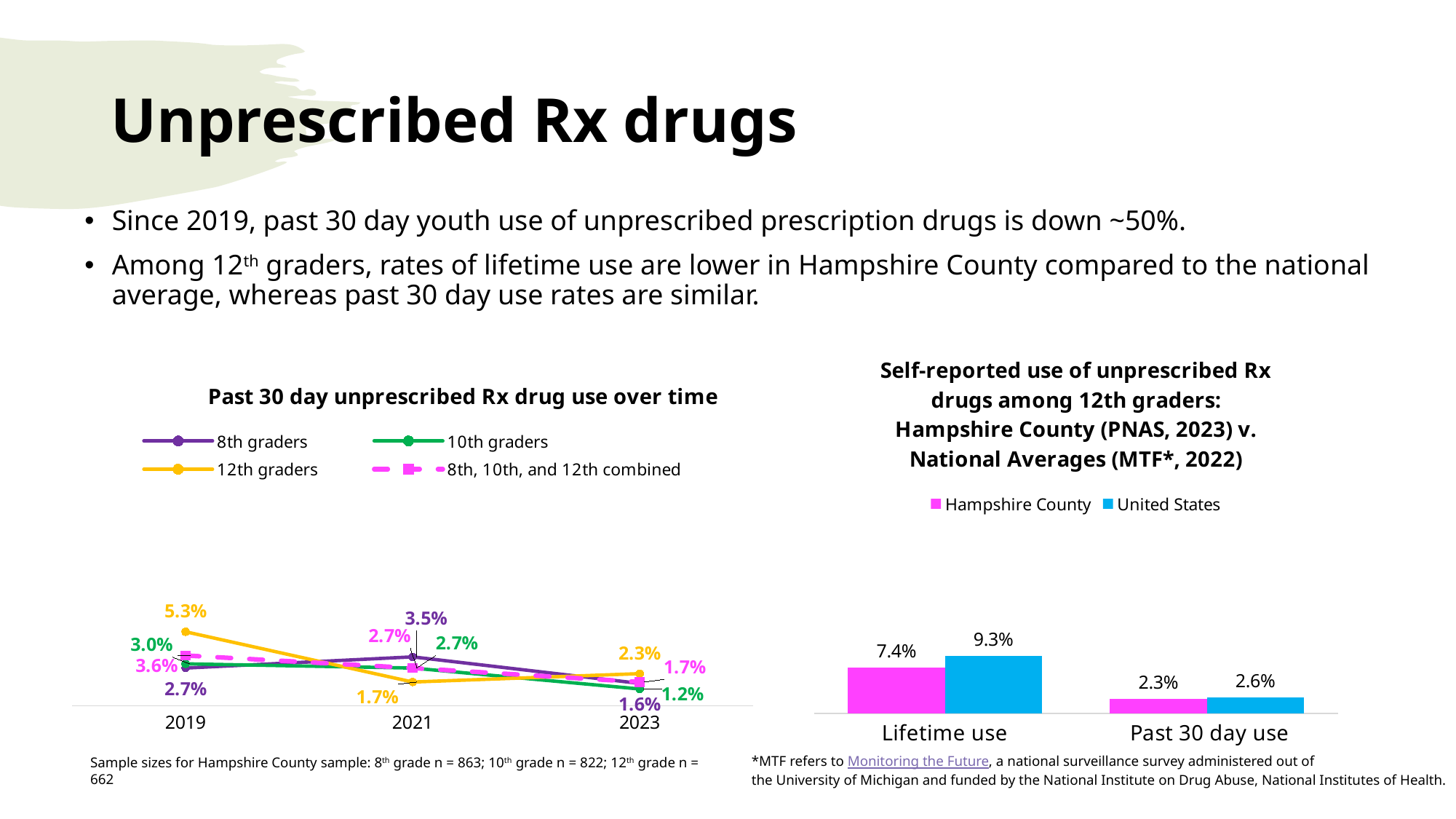
What kind of chart is the 'Self-reported use of unprescribed Rx drugs among 12th graders' chart? bar chart What kind of chart is the 'Past 30 day unprescribed Rx drug use over time' chart? line chart In the 'Past 30 day unprescribed Rx drug use over time' chart, what was the value for 12th graders in 2019? 5.3% In the 'Past 30 day unprescribed Rx drug use over time' chart, what is the difference between the combined value in 2019 and in 2023? 1.9% In the 'Past 30 day unprescribed Rx drug use over time' chart, does the '8th, 10th, and 12th combined' series rise or fall from 2019 to 2023? fall In the 'Past 30 day unprescribed Rx drug use over time' chart, which grade had the highest value in 2019? 12th graders In the 'Self-reported use of unprescribed Rx drugs among 12th graders' chart, what is the lifetime use value for Hampshire County? 7.4% How many years are shown on the x axis of the 'Past 30 day unprescribed Rx drug use over time' chart? 3 In the 'Self-reported use of unprescribed Rx drugs among 12th graders' chart, which is larger for past 30 day use, Hampshire County or United States? United States In the 'Self-reported use of unprescribed Rx drugs among 12th graders' chart, what is the difference between the United States and Hampshire County lifetime use values? 1.9% In the 'Past 30 day unprescribed Rx drug use over time' chart, what was the value for 8th graders in 2021? 3.5% How many series does the legend of the 'Past 30 day unprescribed Rx drug use over time' chart list? 4